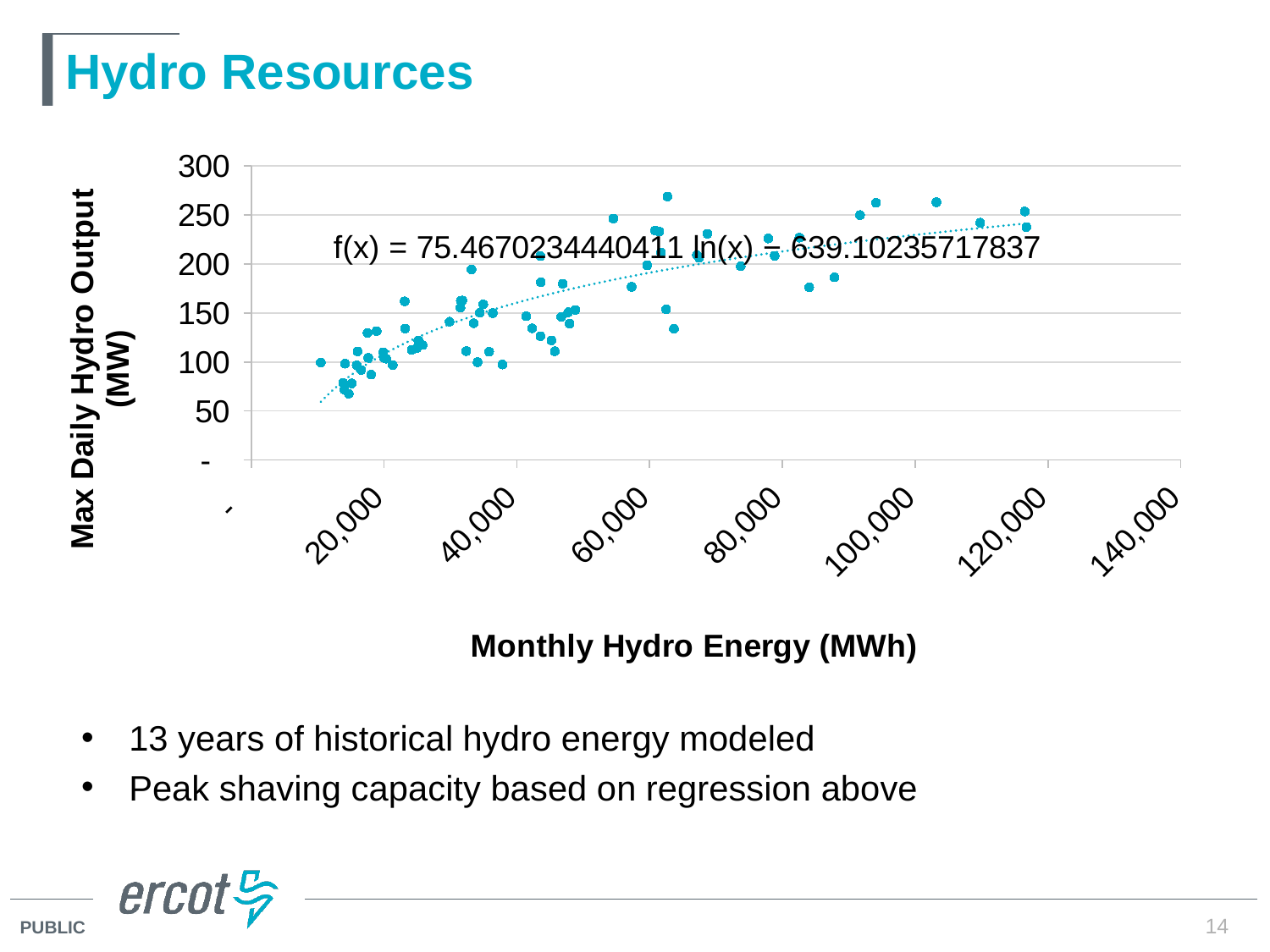
Is the trendline value at 100,000 MWh greater or less than 200 MW? greater Is the highest plotted point on the chart greater or less than 250 MW? greater What is the coefficient of ln(x) in the trendline equation printed on the chart? 75.4670234440411 What is the highest tick value shown on the x axis? 140,000 What is the title of the x axis of the chart? Monthly Hydro Energy (MWh) Does Max Daily Hydro Output generally rise or fall as Monthly Hydro Energy increases? rise Is the lowest plotted point on the chart greater or less than 100 MW? less What kind of chart is shown on the slide? scatter chart What is the constant term in the trendline equation printed on the chart? -639.10235717837 What is the highest tick value shown on the y axis? 300 What is the title of the y axis of the chart? Max Daily Hydro Output (MW)